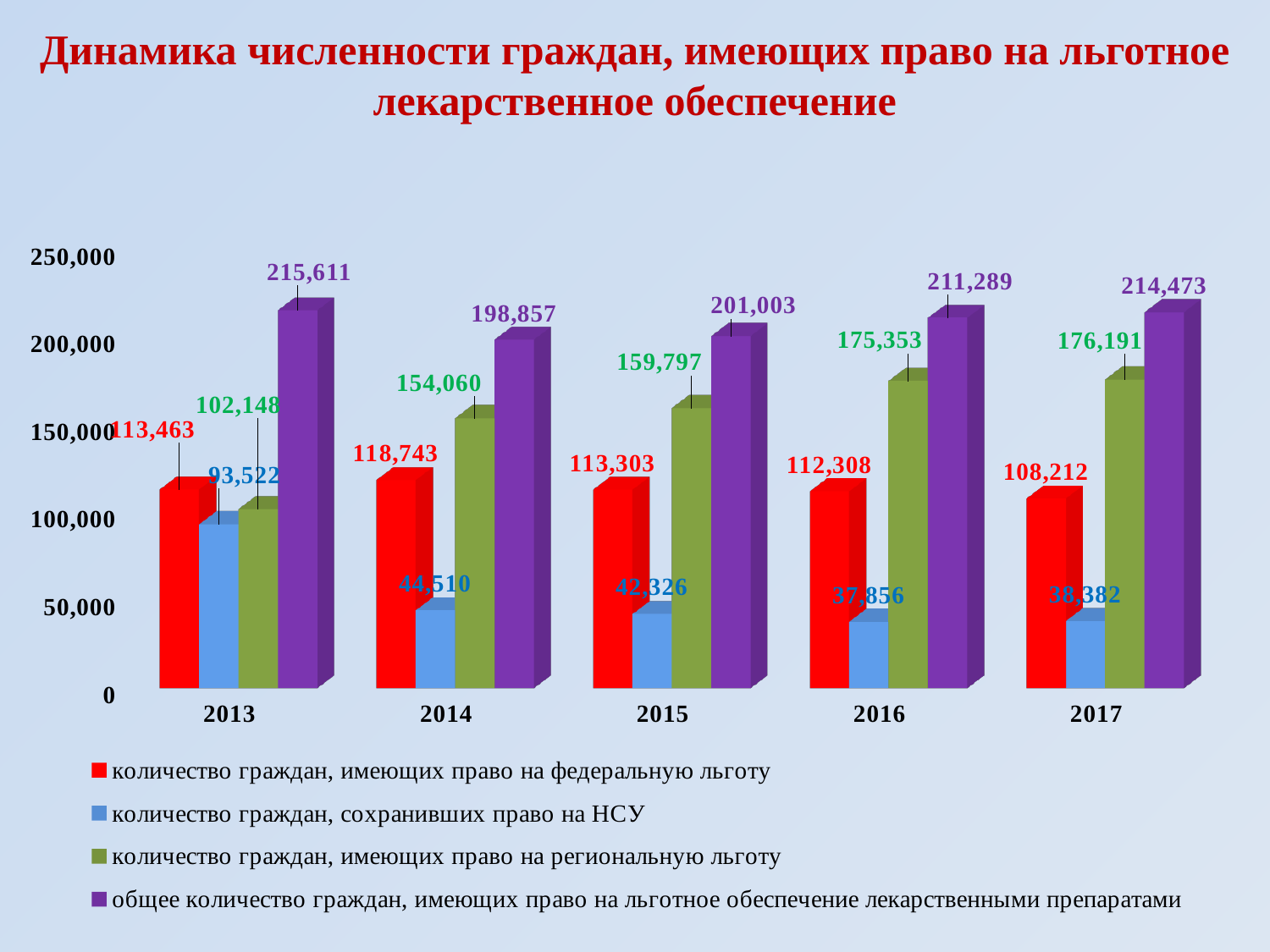
How many years are shown on the x axis? 5 In which year is 'количество граждан, сохранивших право на НСУ' lowest? 2016 Does 'количество граждан, имеющих право на региональную льготу' rise or fall from 2013 to 2017? rise What is the value for 'общее количество граждан, имеющих право на льготное обеспечение лекарственными препаратами' in 2015? 201,003 How many series does the legend list? 4 What type of chart is shown on the slide? bar chart Which is larger: 'количество граждан, имеющих право на федеральную льготу' in 2014 or in 2017? 2014 In which year is 'общее количество граждан, имеющих право на льготное обеспечение лекарственными препаратами' highest? 2013 What colour represents 'количество граждан, имеющих право на федеральную льготу' in the chart? red What is the difference between the 2013 and 2014 values for 'общее количество граждан, имеющих право на льготное обеспечение лекарственными препаратами'? 16,754 What is the value for 'количество граждан, имеющих право на региональную льготу' in 2016? 175,353 What is the value for 'количество граждан, сохранивших право на НСУ' in 2013? 93,522